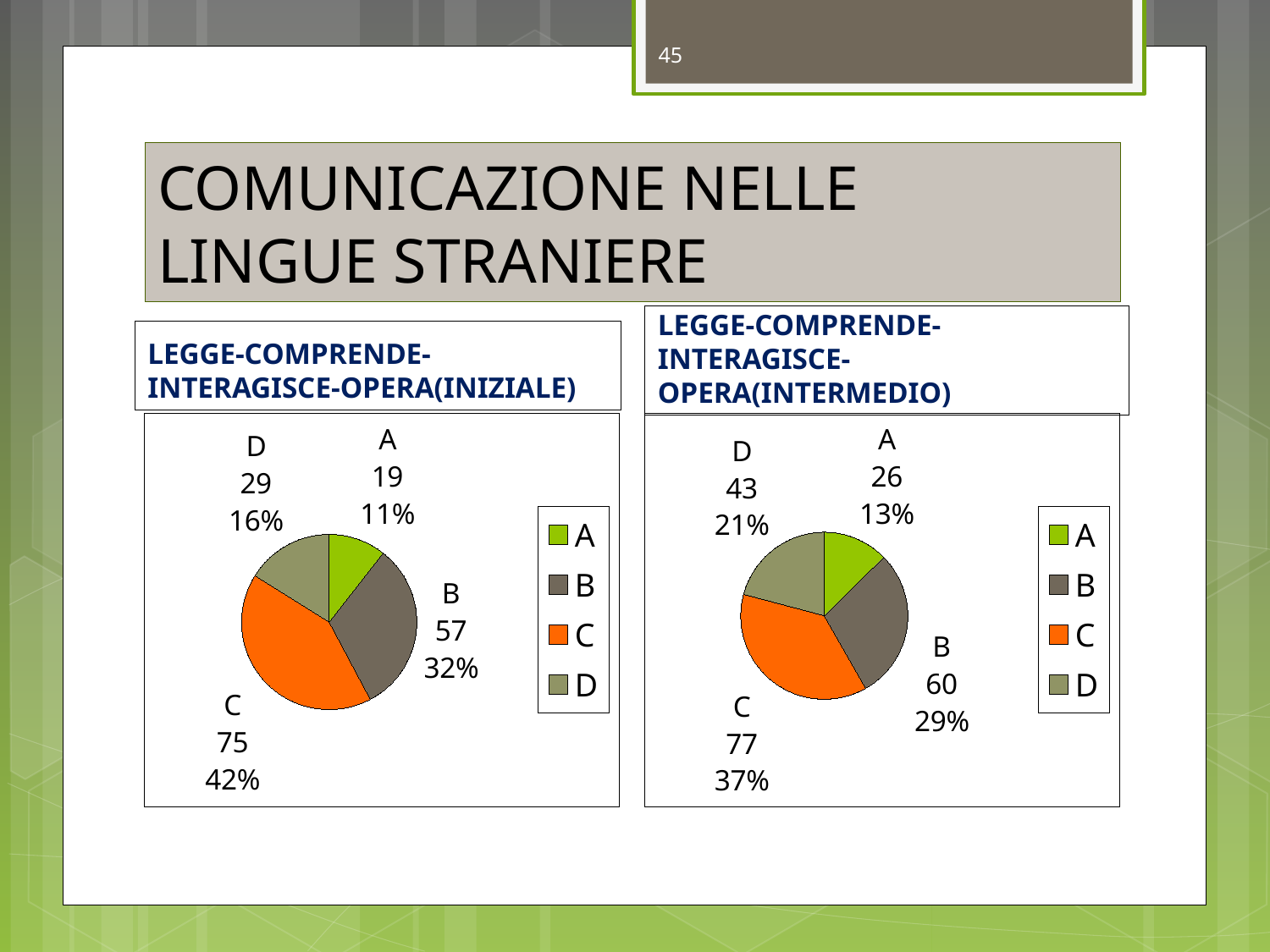
How many categories does the right chart (INTERMEDIO) show? 4 In the right chart (INTERMEDIO), which category has the smallest slice? A In the right chart (INTERMEDIO), what percentage share does category A have? 13% In the left chart (INIZIALE), which colour represents category C in the legend? Orange In the left chart (INIZIALE), what is the value for category C? 75 In the left chart (INIZIALE), which category has the largest slice? C In the right chart (INTERMEDIO), what is the total of all four category values? 206 What type of chart is the left chart (INIZIALE)? Pie chart In the right chart (INTERMEDIO), what is the value for category B? 60 In the left chart (INIZIALE), what percentage share does category D have? 16% In the right chart (INTERMEDIO), which is larger, the value for D or the value for A? D In the left chart (INIZIALE), what is the difference between the values for C and B? 18